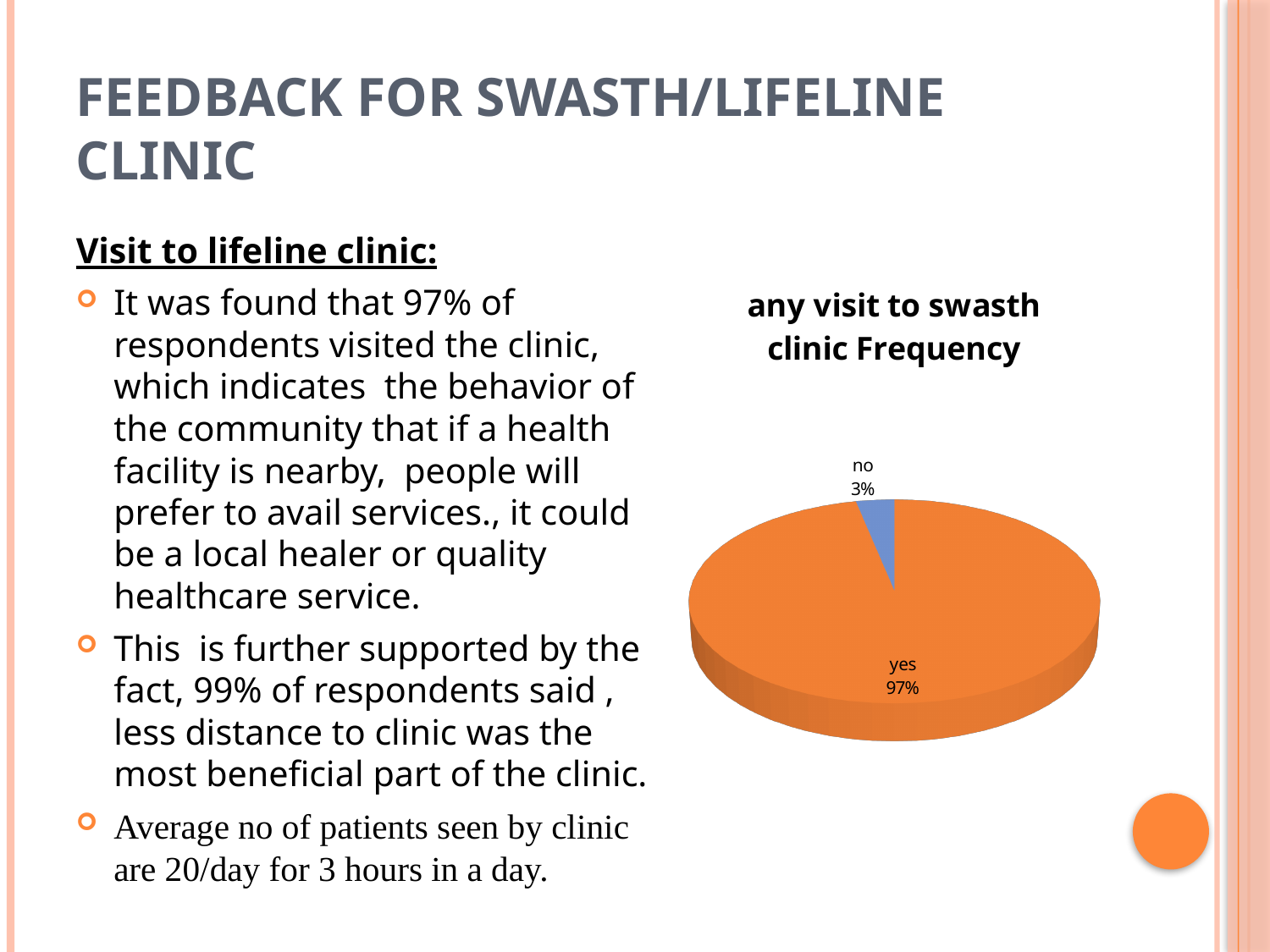
What colour is the "yes" slice of the pie? orange What share of the pie does the "no" slice represent? 3% What percentage of the pie is labelled "no"? 3% Which slice of the pie is the largest? yes How many slices does the pie chart have? 2 What is the title of the chart? any visit to swasth clinic Frequency What is the difference in percentage points between the "yes" and "no" slices? 94 What percentage of the pie is labelled "yes"? 97% Which slice of the pie is the smallest? no Which is larger, the "yes" slice or the "no" slice? yes What type of chart is shown on the slide? pie chart